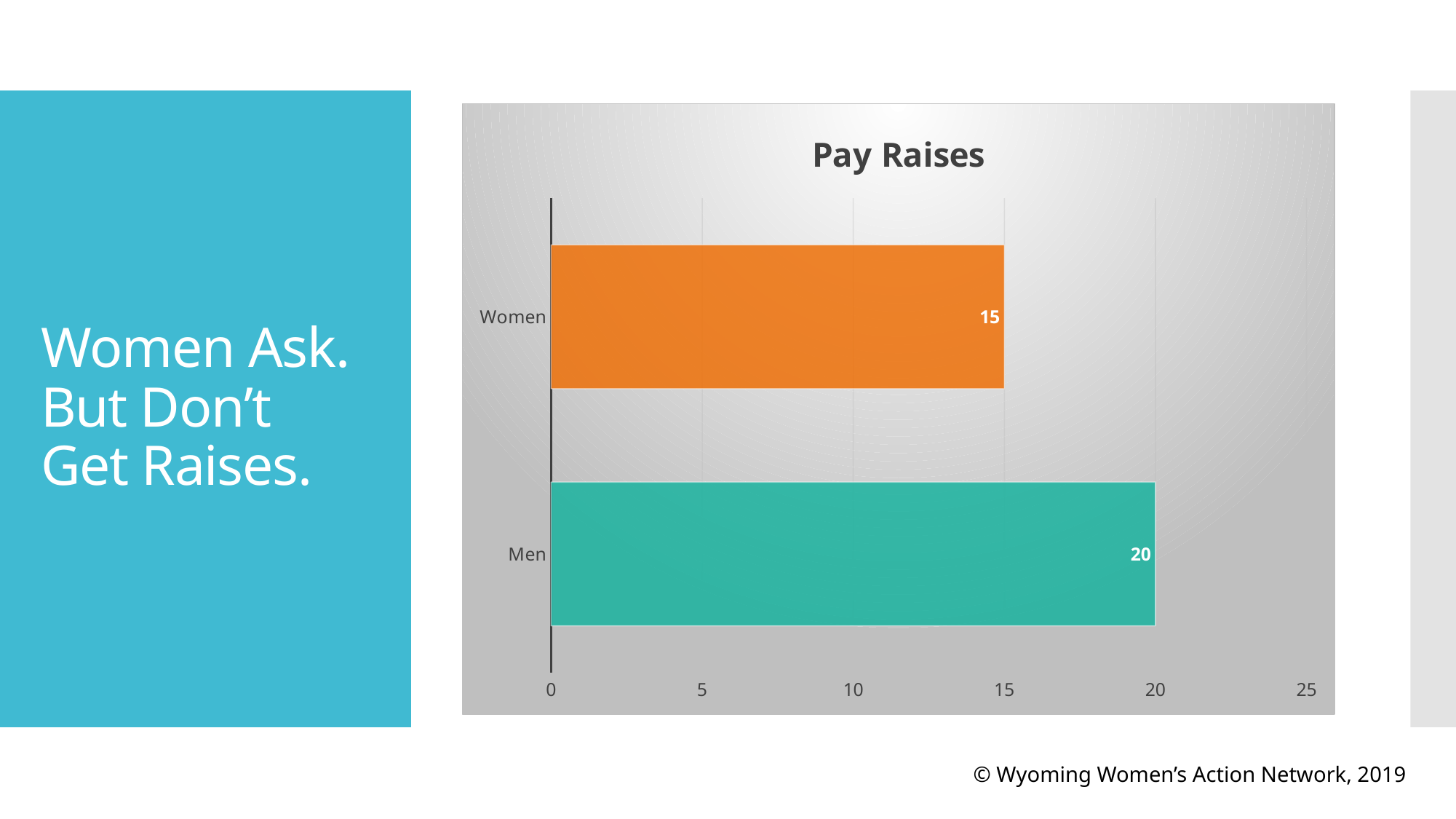
What colour is the bar for Women in the Pay Raises chart? Orange What is the difference between the values for Men and Women in the Pay Raises chart? 5 Which is larger in the Pay Raises chart, the value for Women or the value for Men? Men What kind of chart is shown on the slide? Bar chart Which category has the lowest value in the Pay Raises chart? Women What is the value for Women in the Pay Raises chart? 15 Is the value for Women in the Pay Raises chart greater or less than 10? greater What is the title of the chart on the slide? Pay Raises Is the value for Men in the Pay Raises chart greater or less than 25? less How many categories are shown in the Pay Raises chart? 2 Which category has the highest value in the Pay Raises chart? Men What is the value for Men in the Pay Raises chart? 20